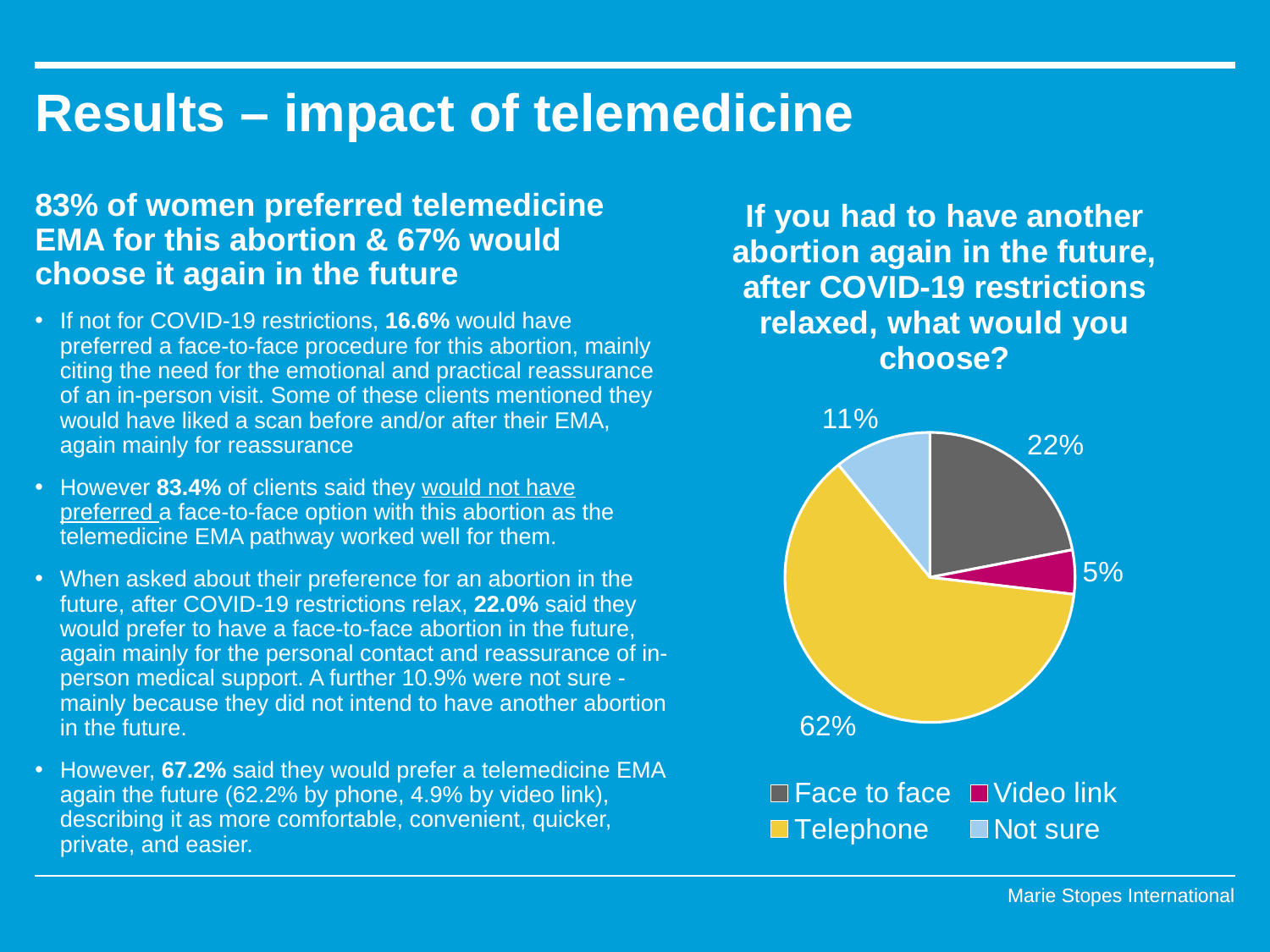
How many entries does the legend list? 4 What kind of chart is shown on the slide? Pie chart What percentage of respondents chose Video link? 5% Which legend entry is shown in yellow? Telephone Which option has the smallest share of the pie? Video link What percentage of respondents chose Telephone? 62% How many slices does the pie chart have? 4 Which option has the largest share of the pie? Telephone Which is larger, the share for Face to face or the share for Not sure? Face to face What percentage of respondents chose Face to face? 22% What is the difference in percentage points between Telephone and Face to face? 40 What percentage of respondents were Not sure? 11%